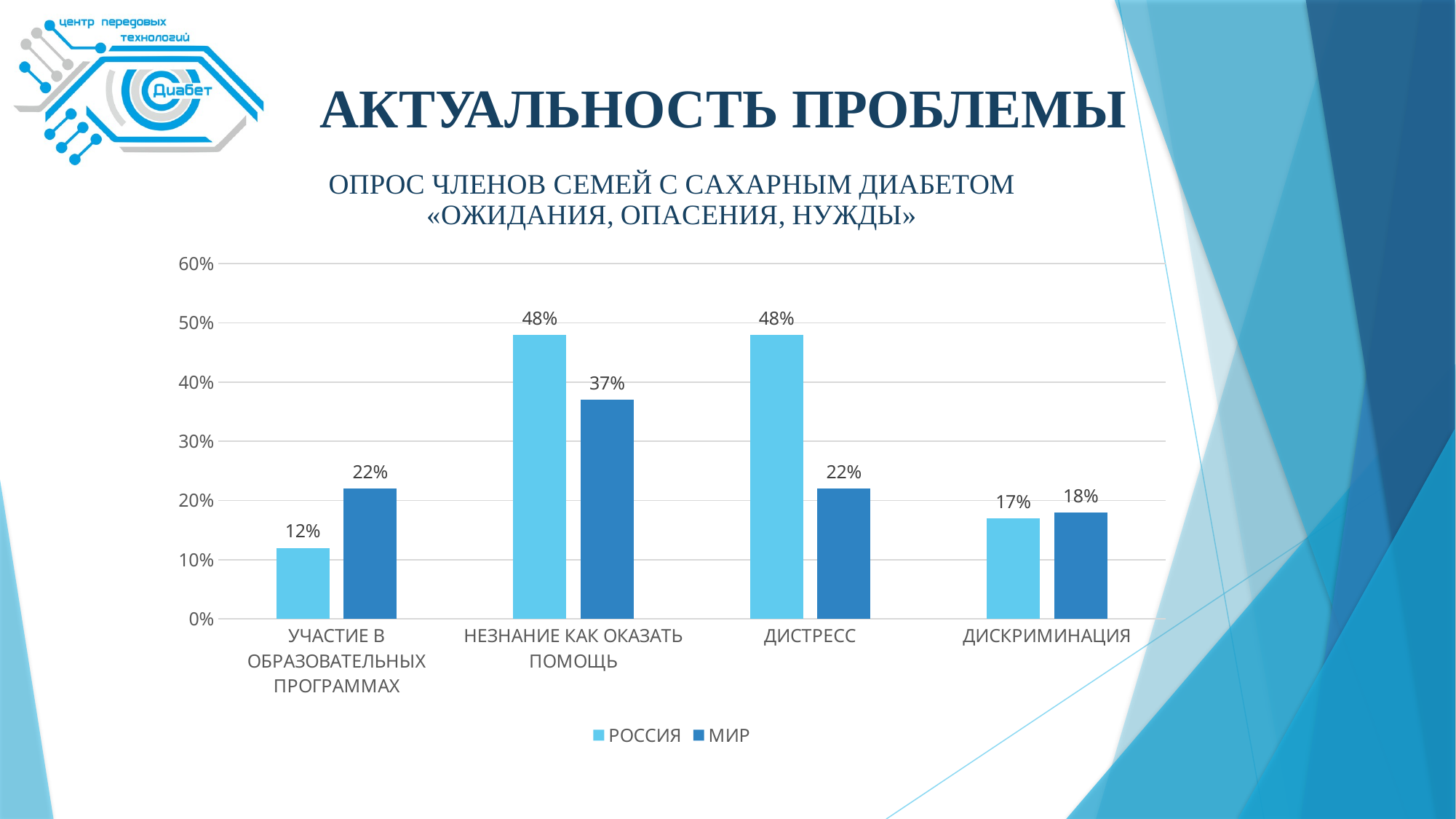
How many series does the legend list? 2 What kind of chart is shown on the slide? bar chart What is the value for РОССИЯ in the ДИСТРЕСС category? 48% Is the value for МИР in the ДИСТРЕСС category greater or less than 30%? less Which category has the highest value for the МИР series? НЕЗНАНИЕ КАК ОКАЗАТЬ ПОМОЩЬ What is the value for МИР in the ДИСКРИМИНАЦИЯ category? 18% What is the value for МИР in the НЕЗНАНИЕ КАК ОКАЗАТЬ ПОМОЩЬ category? 37% Which category has the lowest value for the РОССИЯ series? УЧАСТИЕ В ОБРАЗОВАТЕЛЬНЫХ ПРОГРАММАХ In the УЧАСТИЕ В ОБРАЗОВАТЕЛЬНЫХ ПРОГРАММАХ category, which series has the larger value, РОССИЯ or МИР? МИР What is the difference between the РОССИЯ and МИР values in the ДИСТРЕСС category? 26% What is the value for РОССИЯ in the УЧАСТИЕ В ОБРАЗОВАТЕЛЬНЫХ ПРОГРАММАХ category? 12% How many categories are shown on the x axis? 4